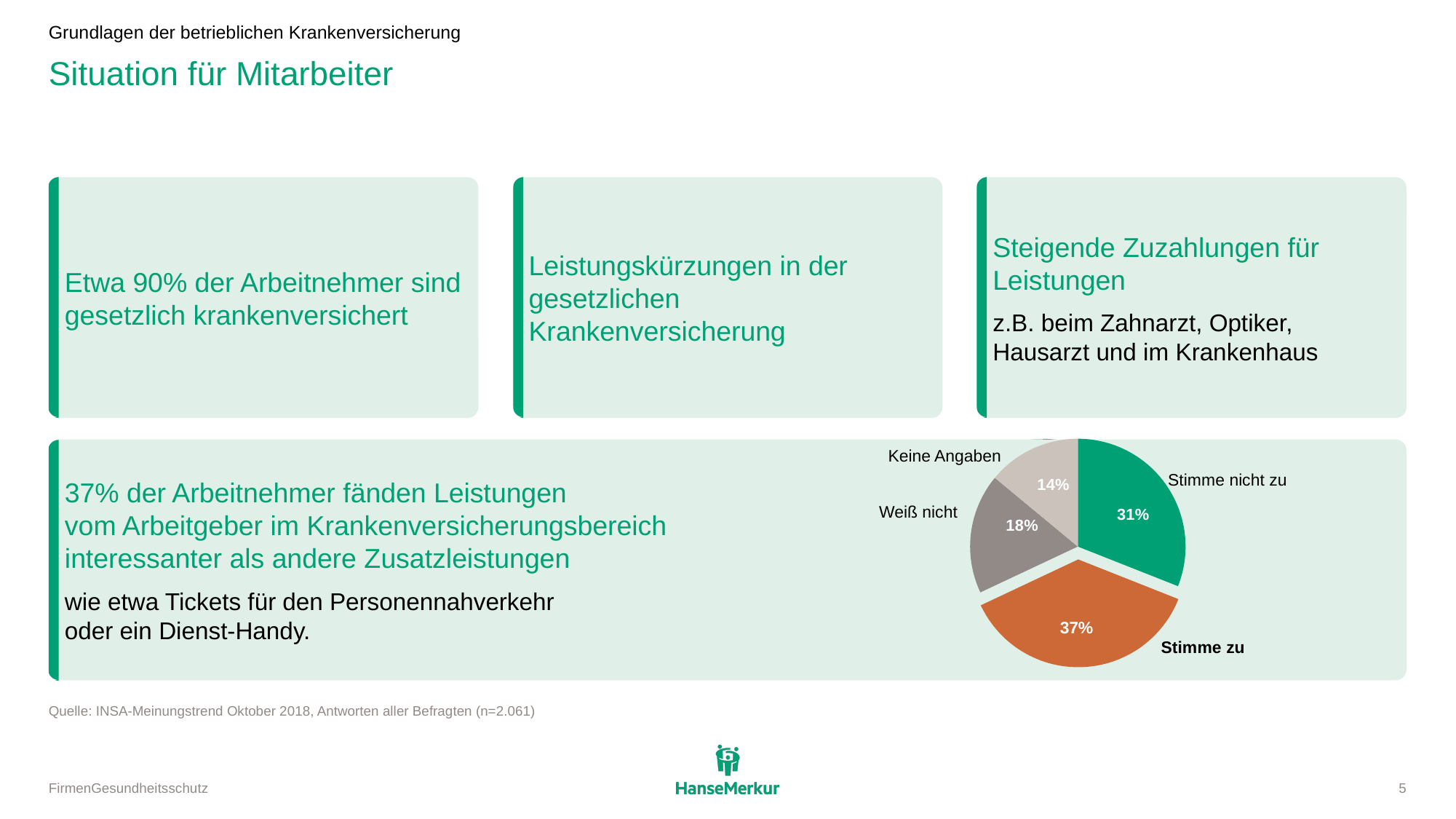
What is the difference between the "Weiß nicht" and "Keine Angaben" slices? 4% What kind of chart is shown on the slide? pie chart How many slices does the pie chart have? 4 Which slice of the pie chart is the smallest? Keine Angaben What is the value for "Stimme zu" in the pie chart? 37% What colour is the "Stimme zu" slice in the pie chart? orange What is the value for "Keine Angaben" in the pie chart? 14% Which slice of the pie chart is the largest? Stimme zu Which is larger in the pie chart, "Weiß nicht" or "Keine Angaben"? Weiß nicht What is the value for "Stimme nicht zu" in the pie chart? 31% What is the value for "Weiß nicht" in the pie chart? 18% What is the difference between the "Stimme zu" and "Stimme nicht zu" slices? 6%